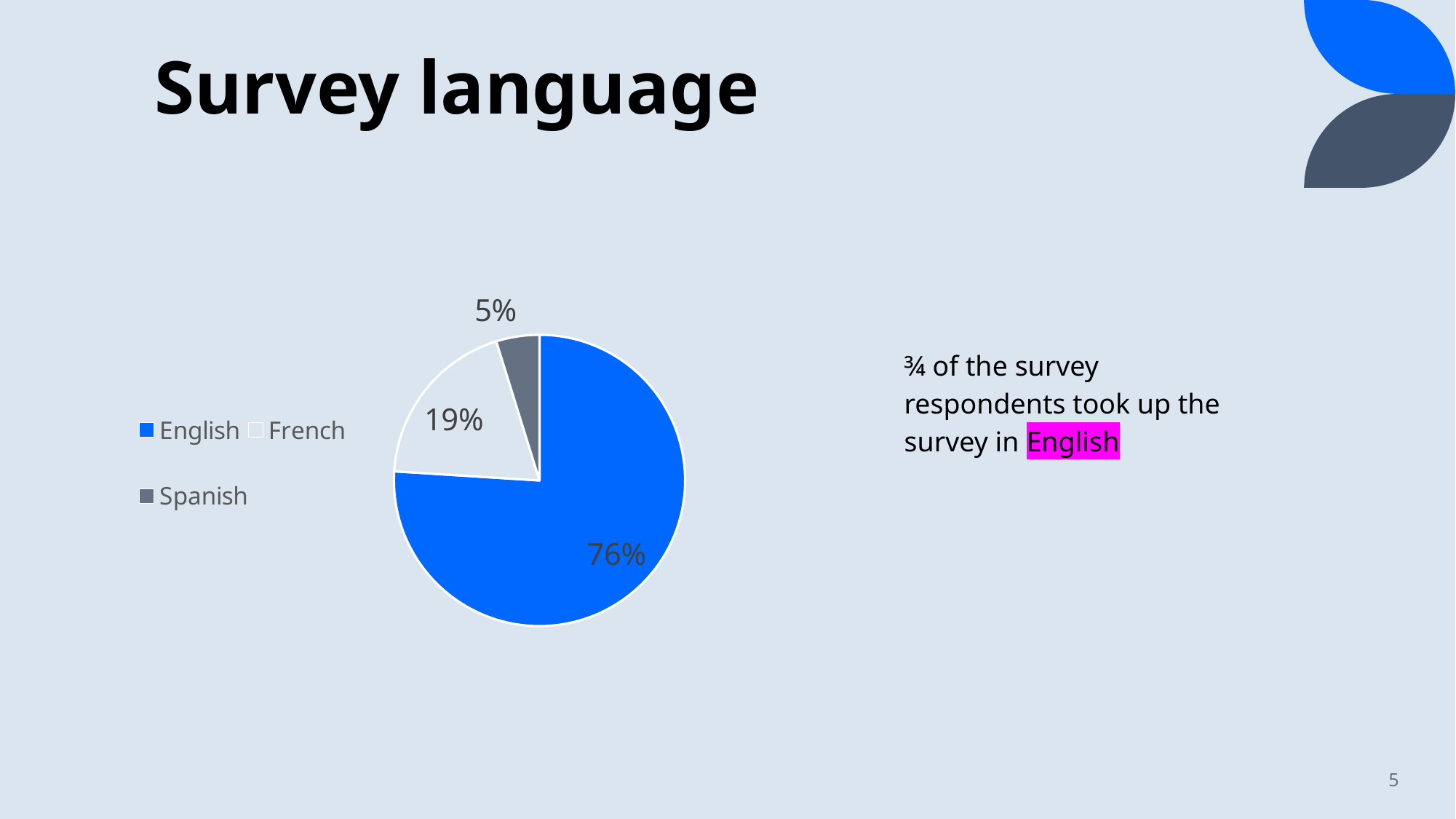
Which language is shown in blue in the pie chart? English What share of the pie does Spanish account for? 5% What share of the pie does English account for? 76% What is the difference in percentage points between the French and Spanish slices? 14 Which slice is larger, French or Spanish? French What languages are listed in the chart legend? English, French, Spanish Which language has the largest slice of the pie? English Which language has the smallest slice of the pie? Spanish What type of chart is shown on the slide? pie chart What is the difference in percentage points between the English and French slices? 57 How many slices does the pie chart have? 3 What share of the pie does French account for? 19%